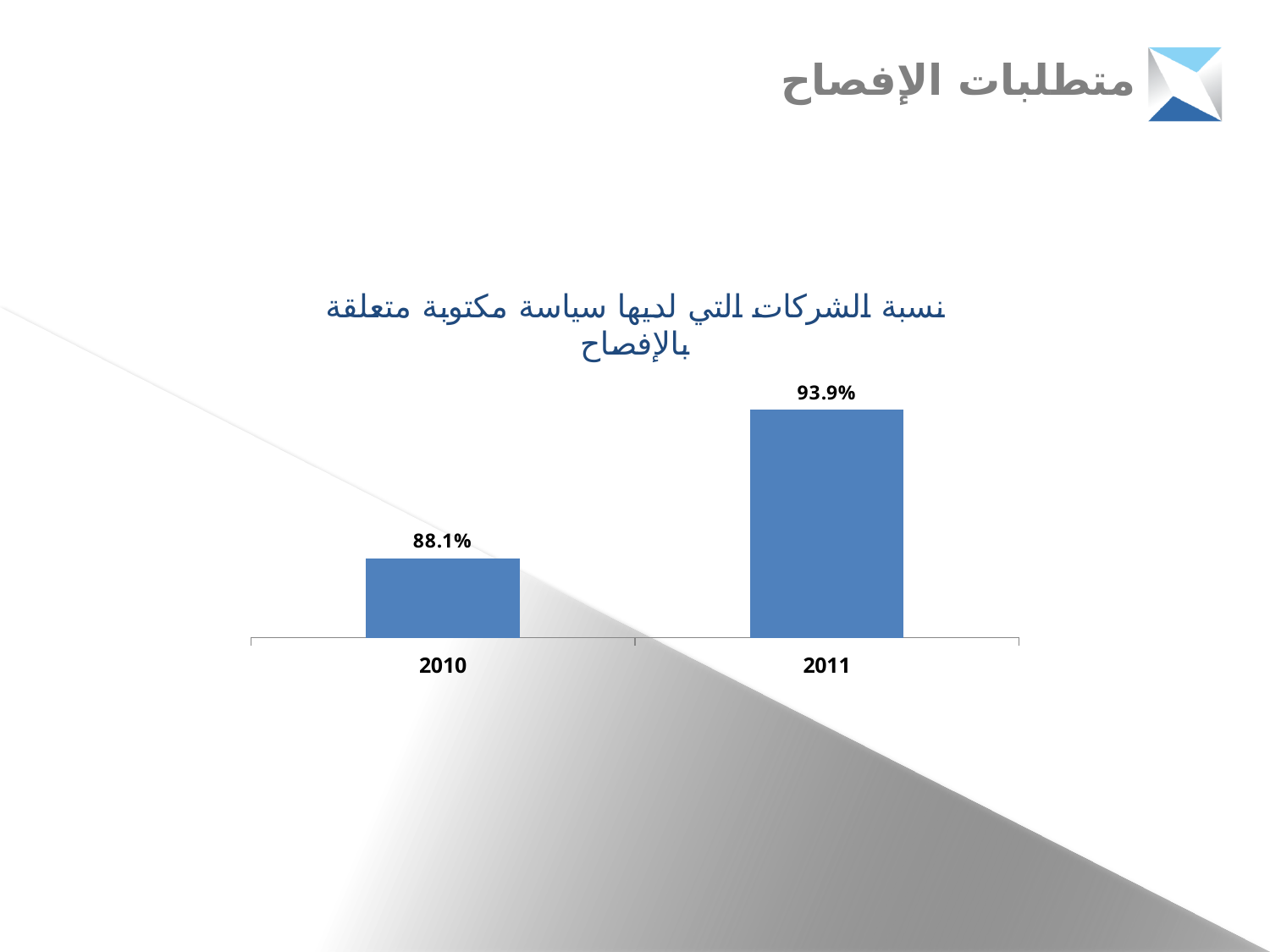
What is the value for 2010? 88.1% Which year has the lowest value? 2010 Which year has the highest value? 2011 What is the value for 2011? 93.9% What is the title of the chart? نسبة الشركات التي لديها سياسة مكتوبة متعلقة بالإفصاح What kind of chart is shown on the slide? bar chart How many categories are shown on the x axis? 2 Do the values rise or fall from 2010 to 2011? rise What is the difference between the values for 2011 and 2010? 5.8% Which is larger, the value for 2010 or the value for 2011? 2011 What colour are the bars in the chart? blue